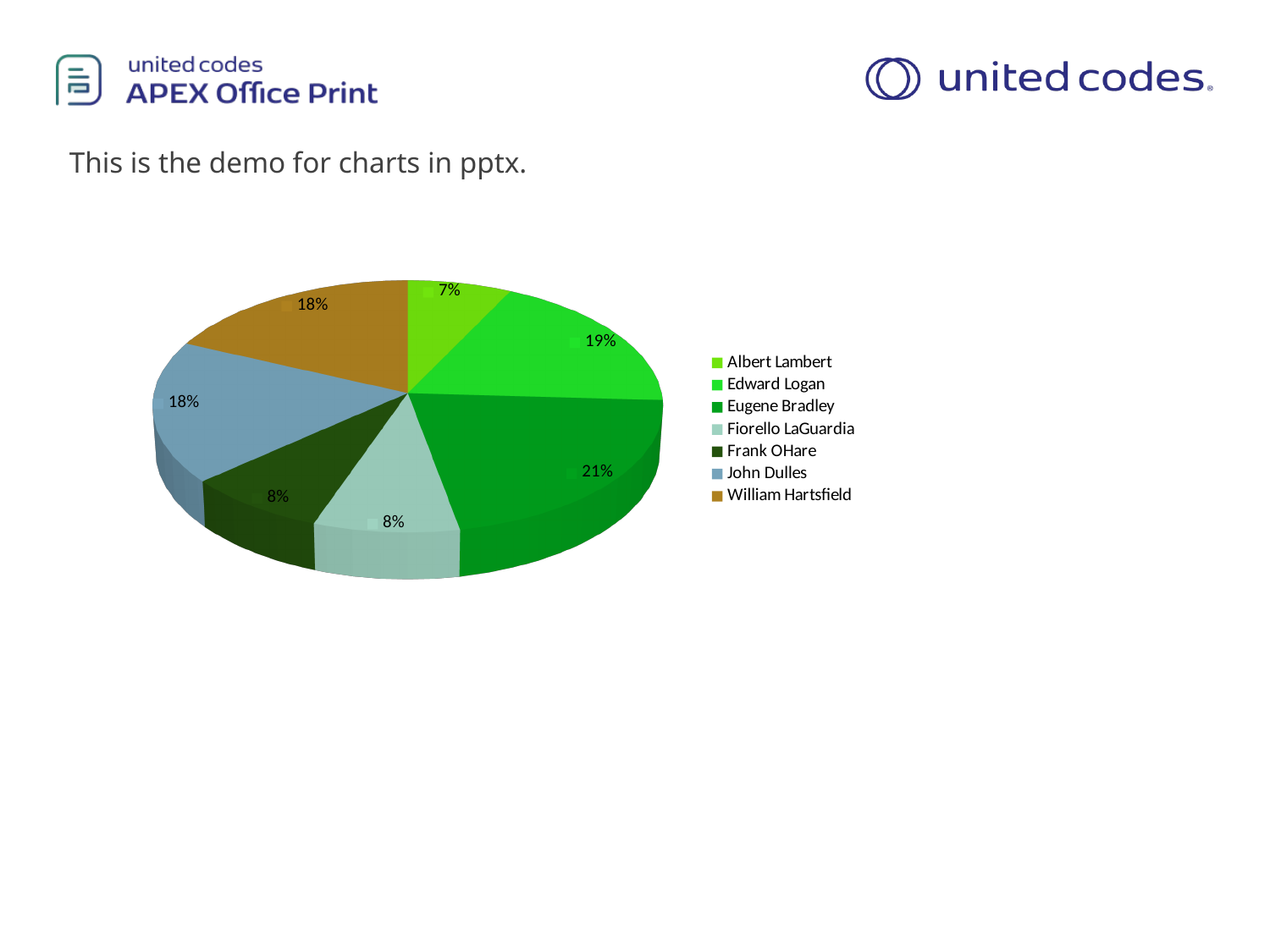
How many slices does the pie chart have? 7 What share of the pie does Frank OHare have? 8% What share of the pie does John Dulles have? 18% Which legend entry is shown in brown? William Hartsfield Which has the larger share, Edward Logan or William Hartsfield? Edward Logan What is the difference in percentage points between Eugene Bradley's share and Albert Lambert's share? 14 What share of the pie does Eugene Bradley have? 21% What kind of chart is shown on the slide? pie chart How many entries does the legend of the pie chart list? 7 Which category has the largest slice of the pie? Eugene Bradley